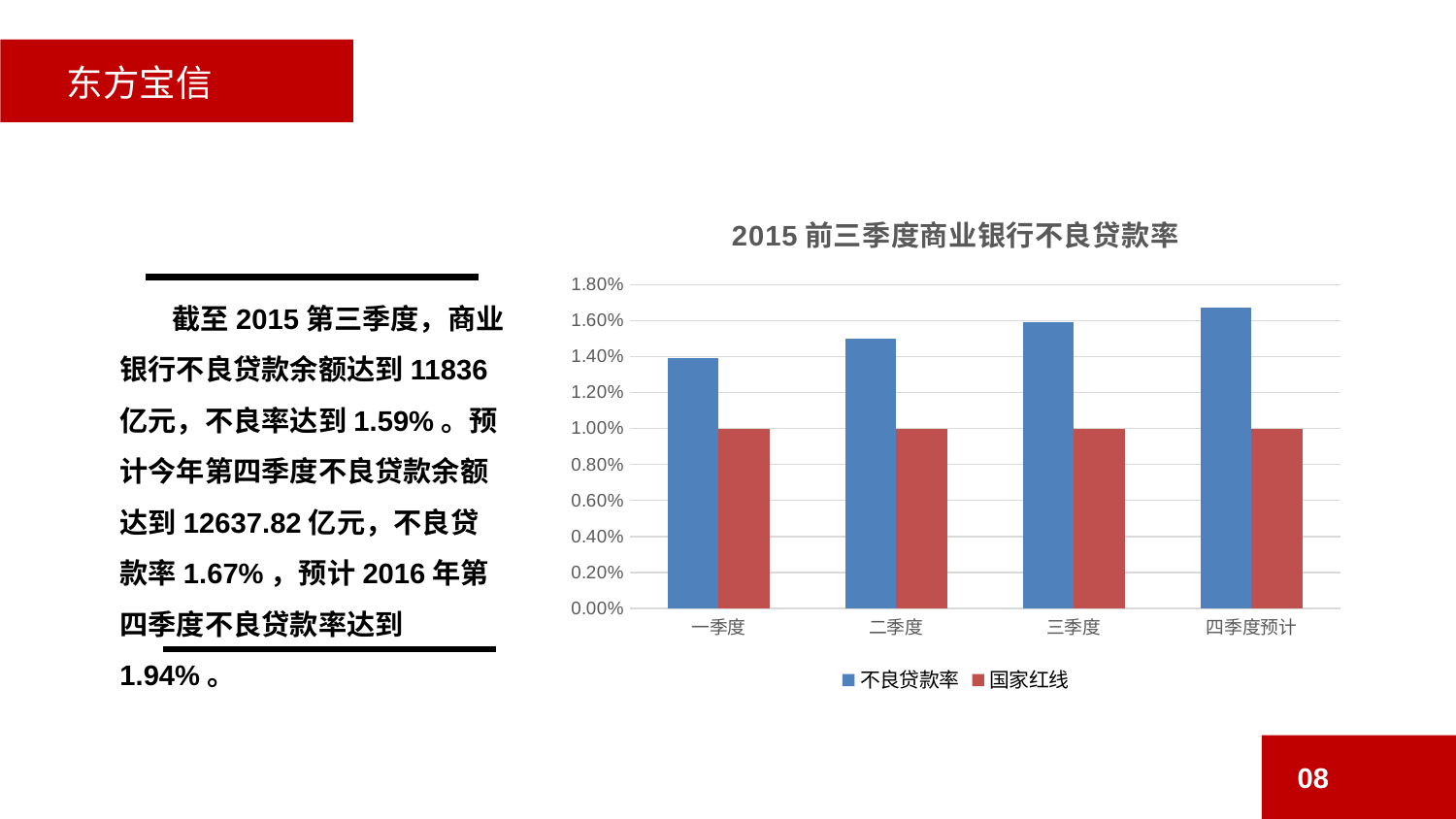
How many series does the legend list? 2 What kind of chart is shown on the slide? bar chart Is the 不良贷款率 value for 四季度预计 greater or less than 1.60%? greater Which category has the highest 不良贷款率? 四季度预计 Which category has the lowest 不良贷款率? 一季度 What is the title of the chart? 2015 前三季度商业银行不良贷款率 What is the value of 国家红线 for 一季度? 1.00% Does 不良贷款率 rise or fall from 一季度 to 四季度预计? rise How many categories are shown on the x axis? 4 Is the 不良贷款率 value for 一季度 greater or less than 1.20%? greater For 三季度, which is larger: 不良贷款率 or 国家红线? 不良贷款率 What is the value of 国家红线 for 四季度预计? 1.00%